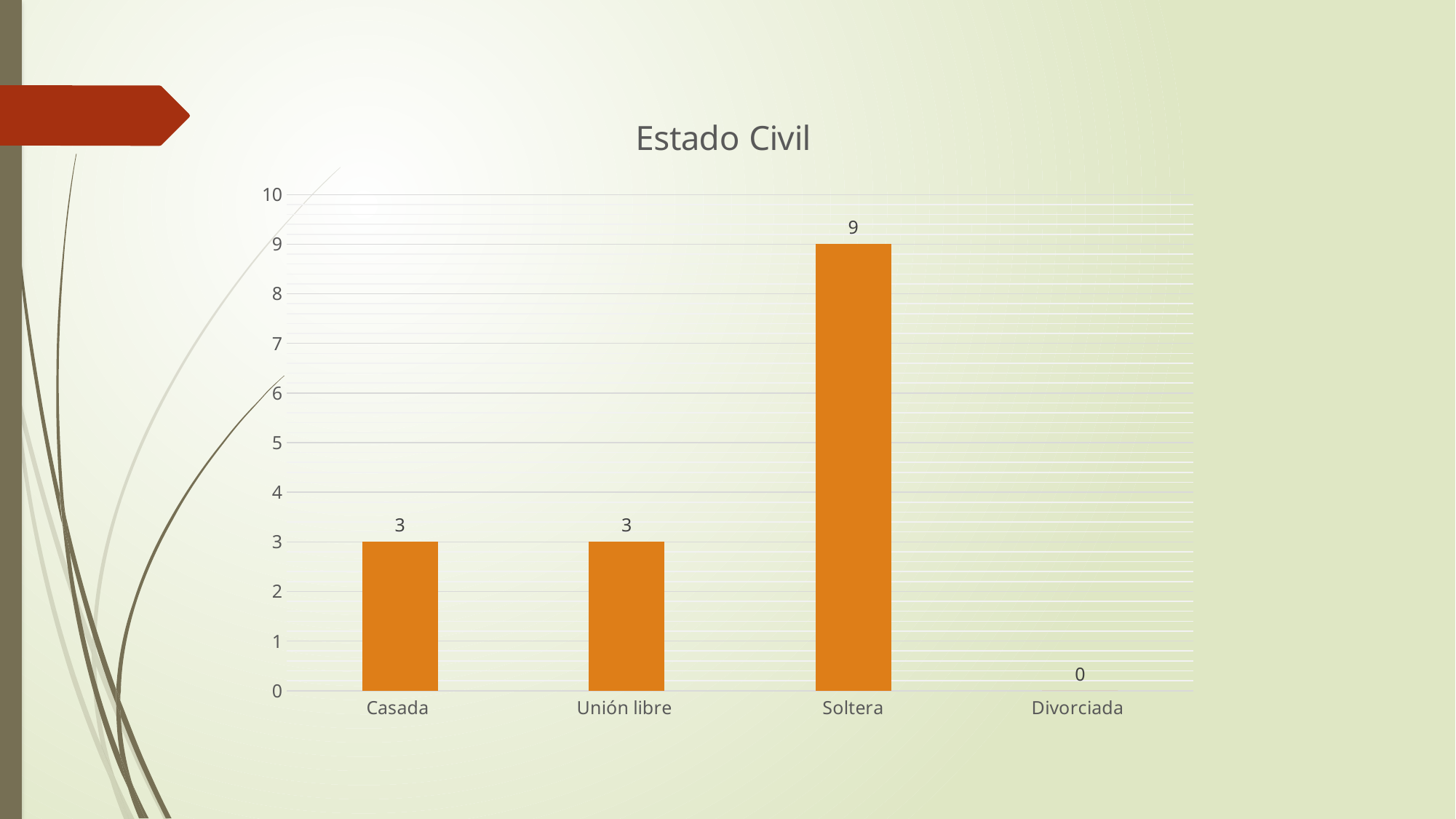
Which category has the lowest value? Divorciada What is the difference between the values for Soltera and Casada? 6 Which category has the highest value? Soltera Is the value for Soltera greater or less than 5? greater What is the title of the chart? Estado Civil What is the value for Casada? 3 Which is larger, the value for Soltera or the value for Unión libre? Soltera How many categories are shown on the x axis? 4 What kind of chart is shown on the slide? Bar chart What is the value for Divorciada? 0 What is the value for Unión libre? 3 What is the value for Soltera? 9